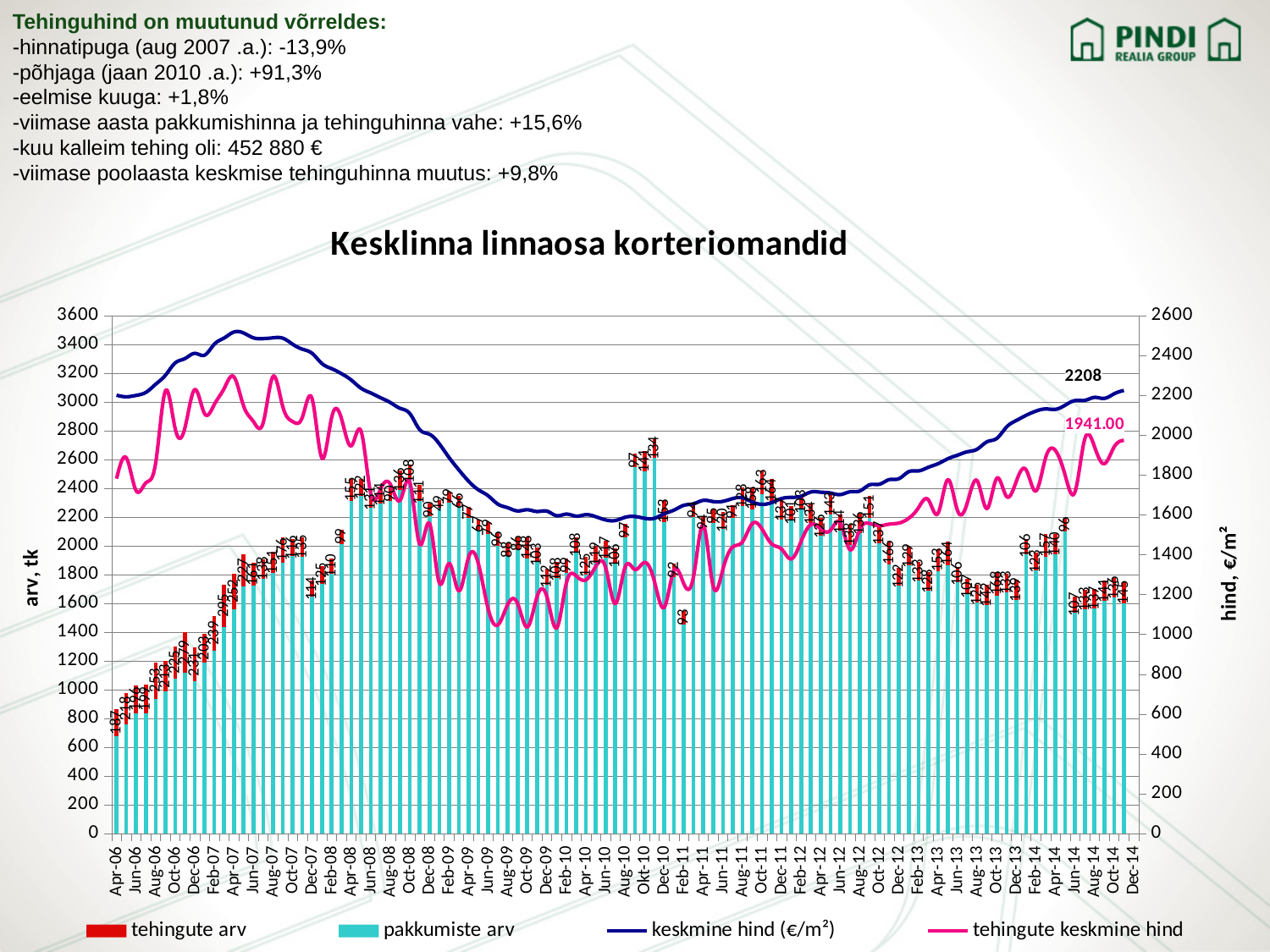
What is the last labelled value of the tehingute keskmine hind line? 1941.00 What is the title of the chart? Kesklinna linnaosa korteriomandid Does the keskmine hind line rise or fall between Apr-07 and Jun-09? fall How many series does the legend list? 4 Is the pakkumiste arv value at Oct-10 greater or less than 2400? greater What is the last labelled value of the keskmine hind (€/m²) line? 2208 What colour represents tehingute arv in the legend? Red What kind of chart is shown on the slide? A combined bar and line chart Is the pakkumiste arv value at Apr-06 greater or less than 1000? less Is the keskmine hind value at Jun-10 greater or less than 1800 €/m²? less What is the difference between the last labelled values of keskmine hind (2208) and tehingute keskmine hind (1941.00)? 267 At the end of the chart (Dec-14), which is higher: keskmine hind or tehingute keskmine hind? keskmine hind